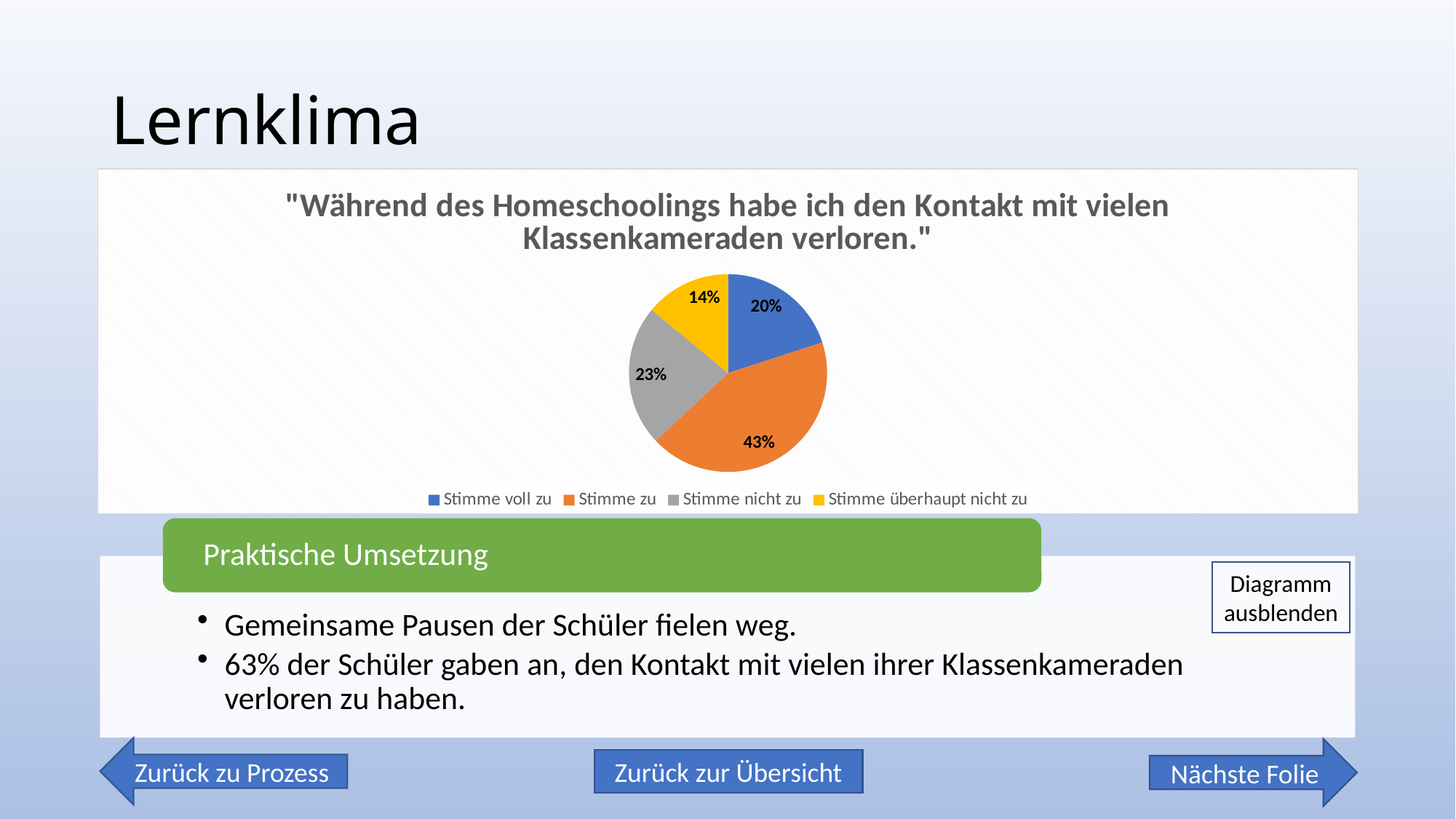
What percentage of respondents answered "Stimme zu"? 43% What kind of chart is shown on the slide? pie chart Which response category has the smallest share of the pie? Stimme überhaupt nicht zu What colour is the slice for "Stimme nicht zu"? grey What percentage of respondents answered "Stimme voll zu"? 20% How many categories does the legend of the pie chart list? 4 What percentage of respondents answered "Stimme nicht zu"? 23% What is the combined share of "Stimme voll zu" and "Stimme zu"? 63% Which response category has the largest share of the pie? Stimme zu What percentage of respondents answered "Stimme überhaupt nicht zu"? 14% What is the difference in percentage points between "Stimme zu" and "Stimme voll zu"? 23 Which is larger: the share for "Stimme nicht zu" or the share for "Stimme überhaupt nicht zu"? Stimme nicht zu